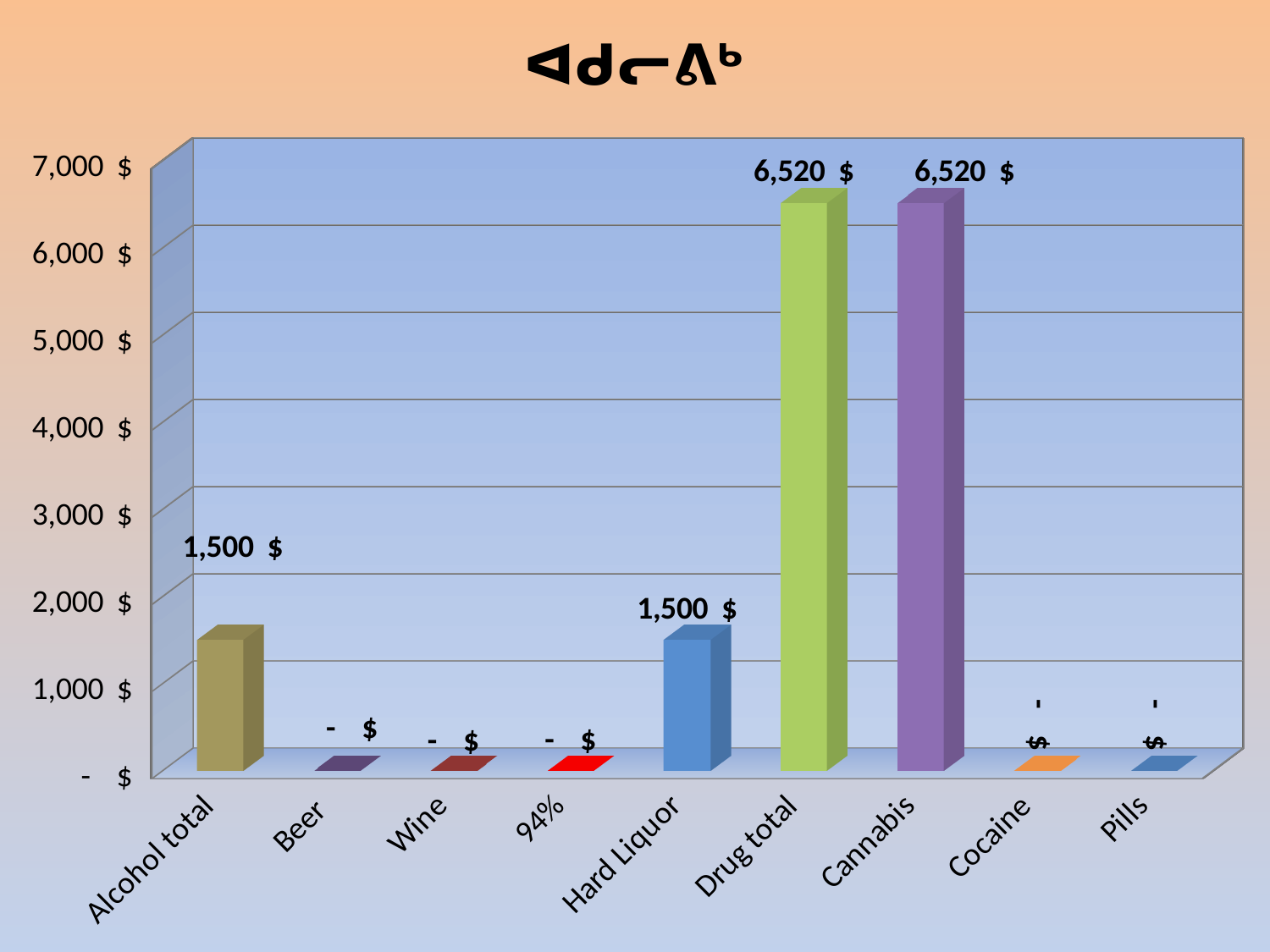
What is the value for Alcohol total? 1,500 $ Is the value for Alcohol total greater or less than 2,000 $? less What is the difference between the values for Drug total and Alcohol total? 5,020 $ What kind of chart is shown on the slide? bar chart What value label is printed for Beer? - $ What is the value for Hard Liquor? 1,500 $ Which is larger, the value for Cannabis or the value for Hard Liquor? Cannabis What is the value for Drug total? 6,520 $ What is the difference between the values for Cannabis and Hard Liquor? 5,020 $ Is the value for Drug total greater or less than 6,000 $? greater What is the value for Cannabis? 6,520 $ How many categories are shown on the x axis? 9